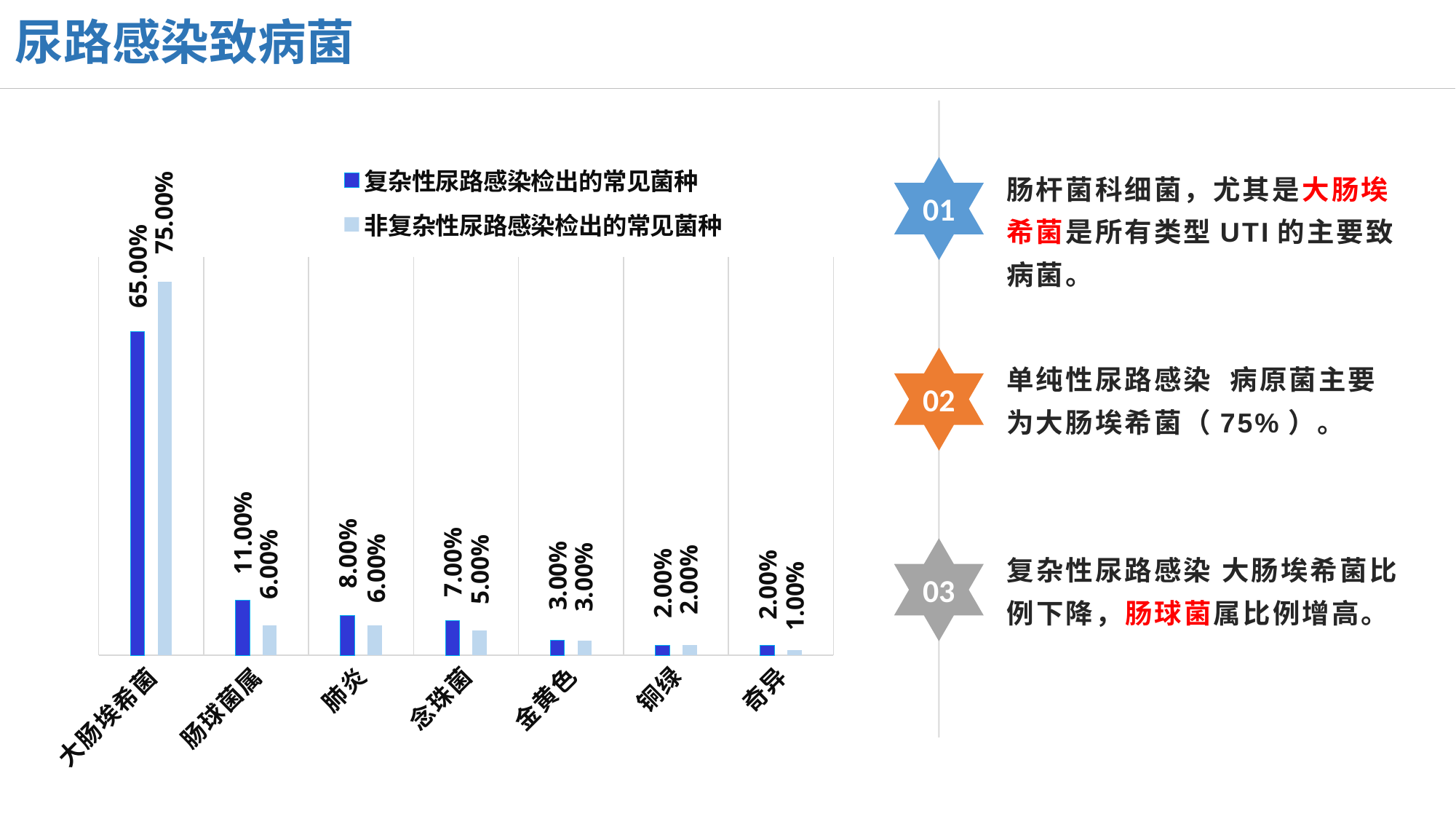
Which series is shown in dark blue in the legend? 复杂性尿路感染检出的常见菌种 How many series does the legend list? 2 For 肠球菌属, which series has the larger value: 复杂性尿路感染检出的常见菌种 or 非复杂性尿路感染检出的常见菌种? 复杂性尿路感染检出的常见菌种 What is the value for 大肠埃希菌 in the 非复杂性尿路感染检出的常见菌种 series? 75.00% How many categories are shown on the x axis of the chart? 7 What is the value for 念珠菌 in the 非复杂性尿路感染检出的常见菌种 series? 5.00% What is the difference between the 非复杂性 and 复杂性 values for 大肠埃希菌? 10.00% Which category has the lowest value in the 非复杂性尿路感染检出的常见菌种 series? 奇异 What is the value for 肠球菌属 in the 复杂性尿路感染检出的常见菌种 series? 11.00% What type of chart is shown on the slide? Bar chart Which category has the highest value in the 非复杂性尿路感染检出的常见菌种 series? 大肠埃希菌 What is the value for 大肠埃希菌 in the 复杂性尿路感染检出的常见菌种 series? 65.00%